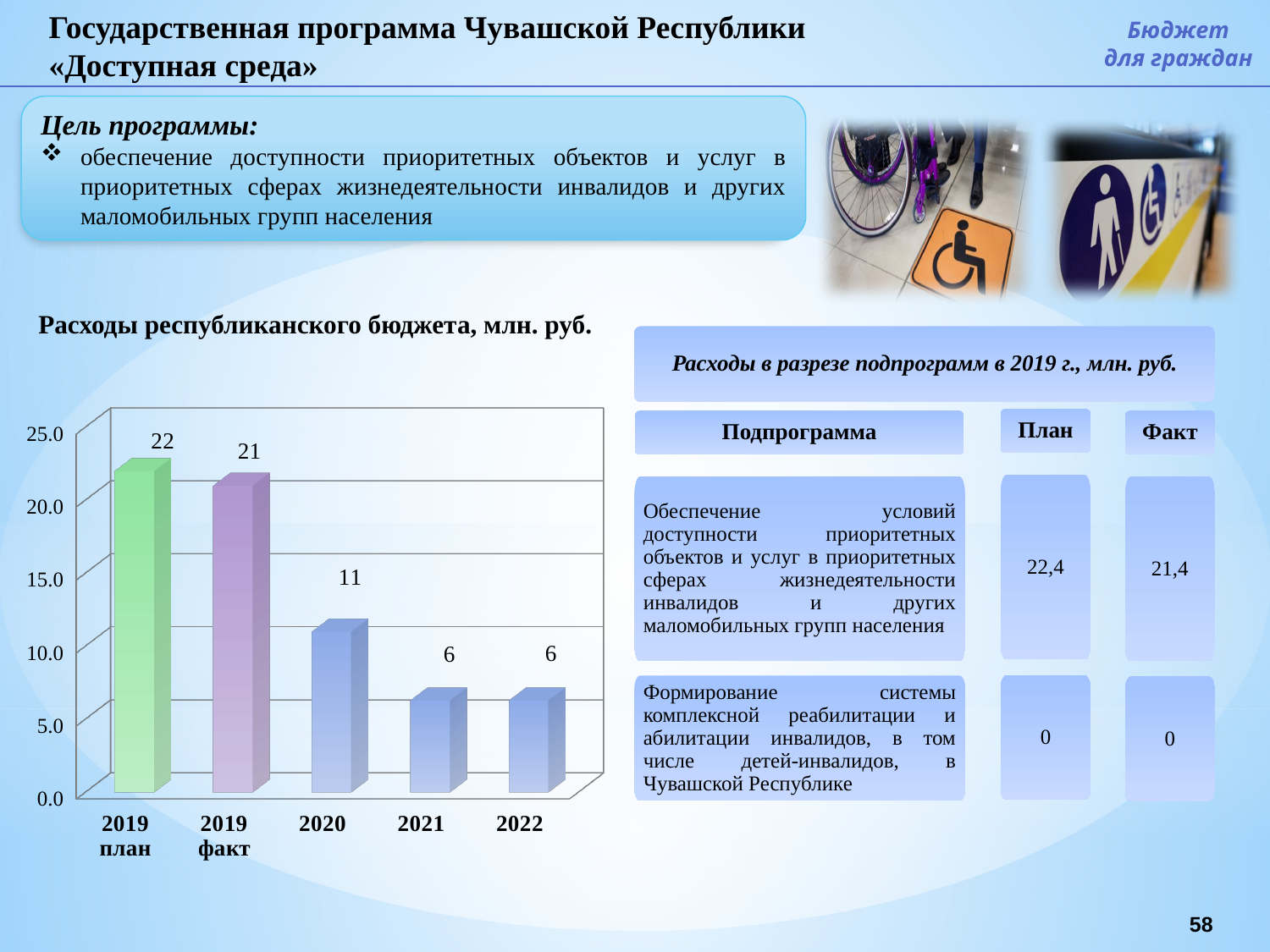
What is the value for 2020 in the chart "Расходы республиканского бюджета, млн. руб."? 11 Is the value for 2020 greater or less than 10.0? greater What kind of chart is shown on the slide? bar chart How many categories are shown on the x axis of the chart? 5 What is the value for 2019 факт in the chart? 21 What is the difference between the values for 2019 факт and 2020? 10 What is the value for 2019 план in the chart? 22 What is the difference between the values for 2019 план and 2019 факт? 1 Which is larger, the value for 2020 or the value for 2021? 2020 Do the values rise or fall from 2019 план to 2021? fall Which category has the highest value in the chart? 2019 план What is the title of the chart on the slide? Расходы республиканского бюджета, млн. руб.